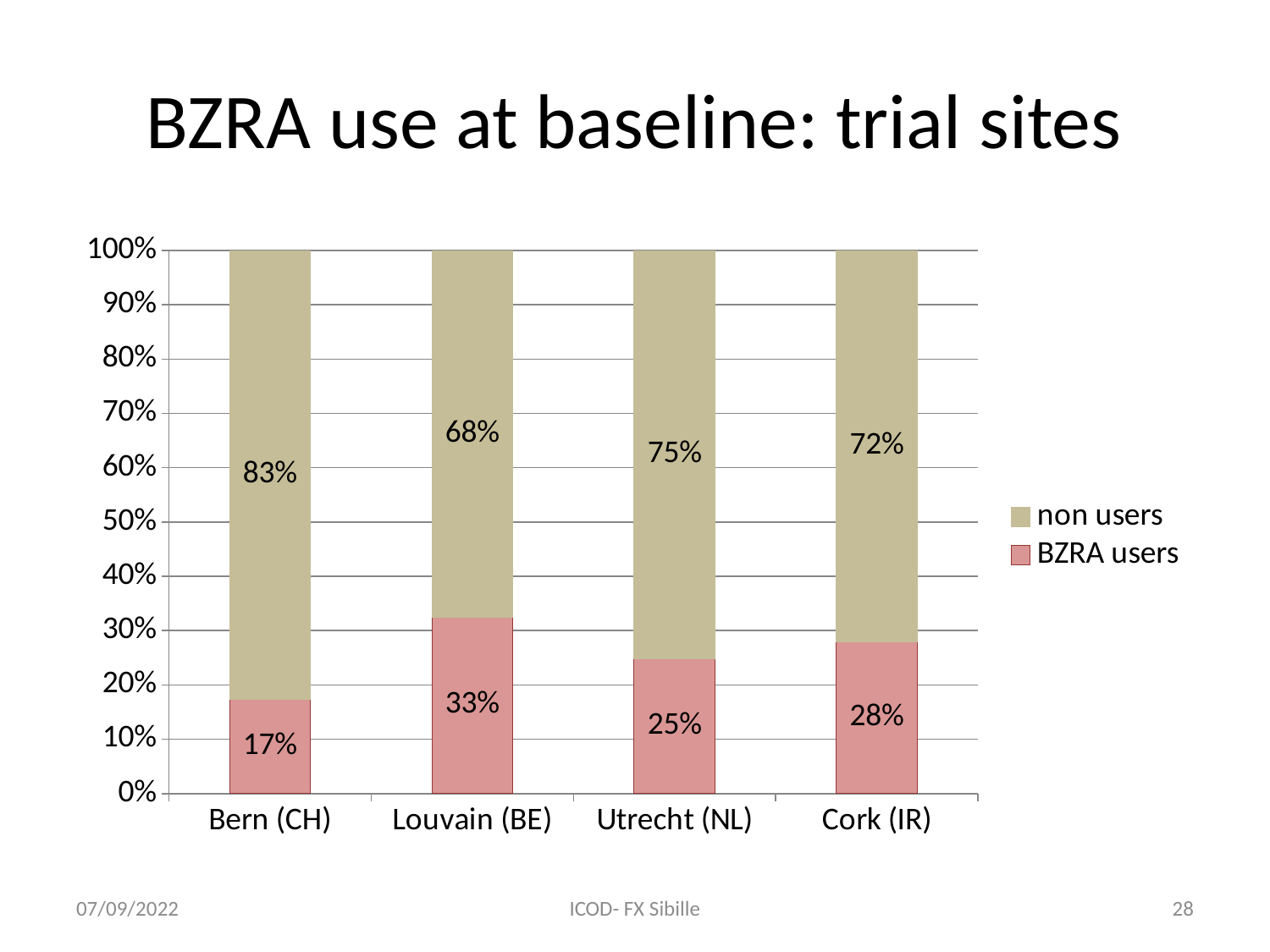
Which site has a larger percentage of BZRA users, Cork (IR) or Utrecht (NL)? Cork (IR) What percentage of BZRA users is shown for Utrecht (NL)? 25% What is the difference in the BZRA users percentage between Louvain (BE) and Bern (CH)? 16% What percentage of non users is shown for Louvain (BE)? 68% What kind of chart is shown on the slide? Stacked bar chart What percentage of non users is shown for Cork (IR)? 72% How many series does the legend list? 2 What is the title of the chart on the slide? BZRA use at baseline: trial sites What percentage of BZRA users is shown for Bern (CH)? 17% Which trial site has the lowest percentage of BZRA users? Bern (CH) How many trial sites are shown on the x axis? 4 Which trial site has the highest percentage of BZRA users? Louvain (BE)